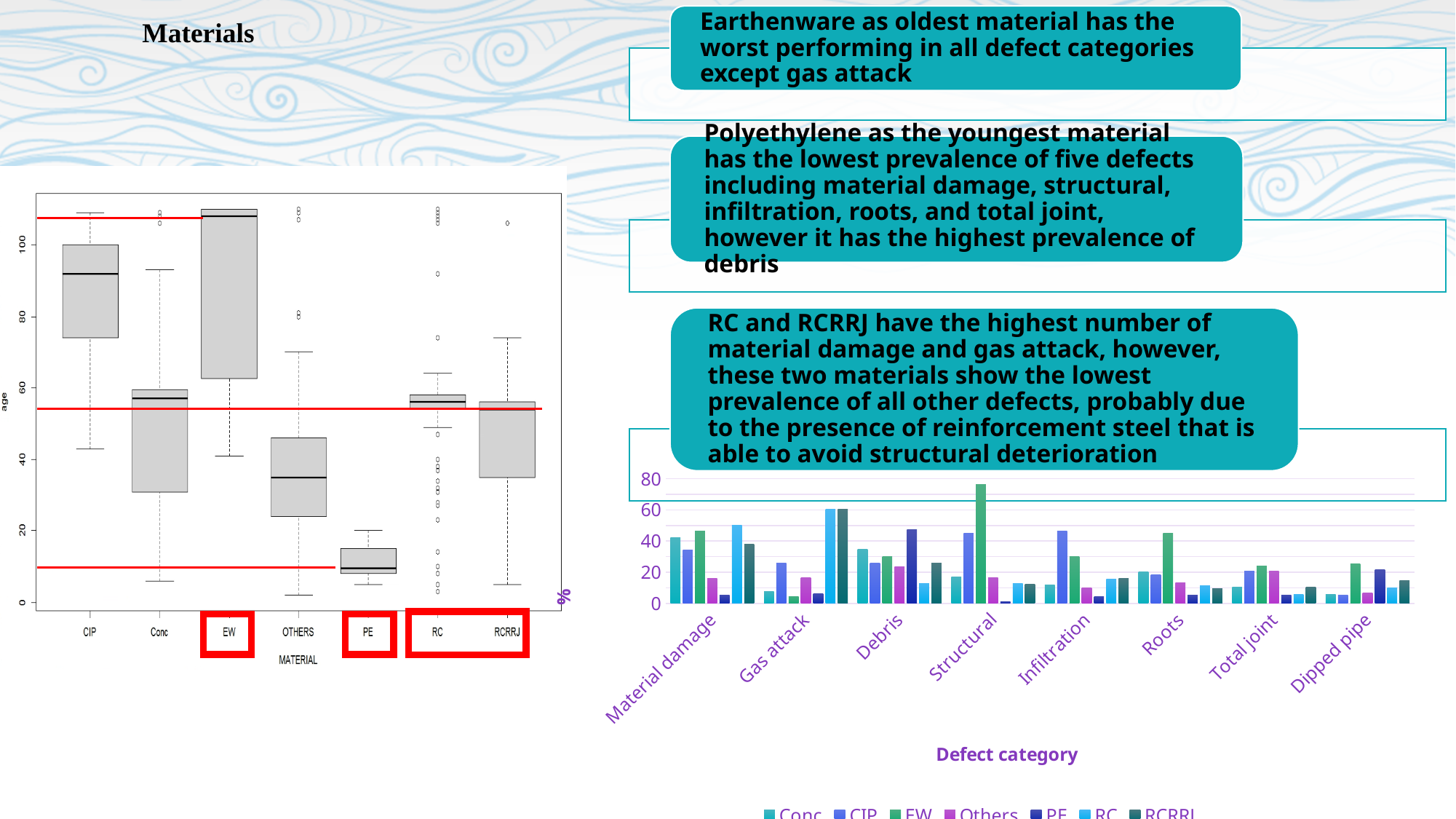
In the box plot on the left, which material has the lowest median age? PE In the bar chart on the right, is the value for CIP in the Infiltration category greater or less than 40? greater In the box plot on the left, how many materials are shown on the x axis? 7 What kind of chart is the chart on the right of the slide, with the x axis labelled 'Defect category'? bar chart In the bar chart on the right, which is larger in the Structural category: EW or CIP? EW In the bar chart on the right, how many series does the legend list? 7 In the bar chart on the right, how many defect categories are shown on the x axis? 8 In the bar chart on the right, which material has the lowest value for Material damage? PE In the bar chart on the right, is the value for PE in the Material damage category greater or less than 20? less In the bar chart on the right, which material has the highest value for Structural? EW In the bar chart on the right, which material has the highest value for Roots? EW In the bar chart on the right, is the value for EW in the Structural category greater or less than 60? greater